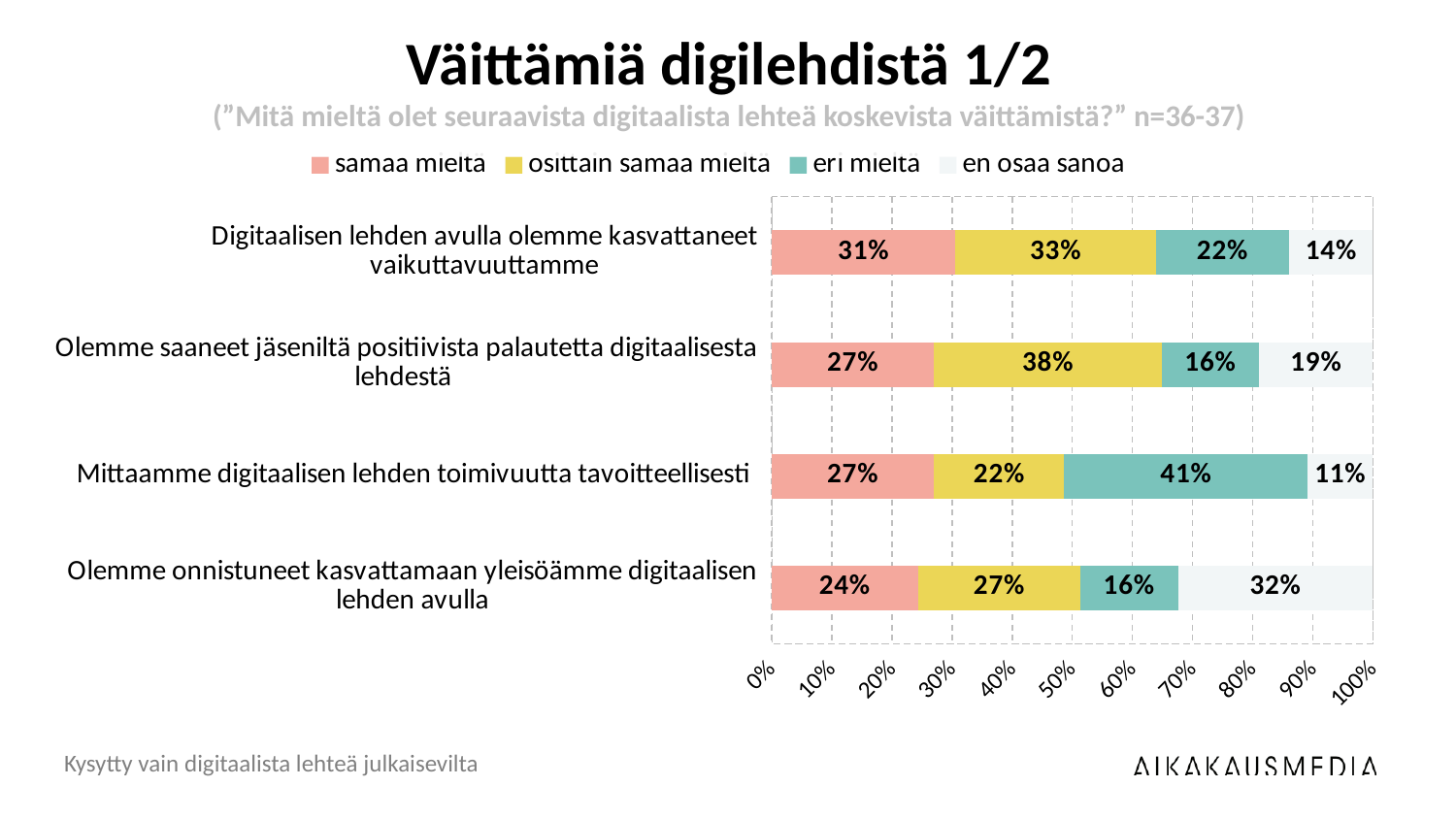
How many statements (categories) are plotted in the chart? 4 What kind of chart is shown on the slide? stacked bar chart How many series does the legend list? 4 What is the title of the chart on the slide? Väittämiä digilehdistä 1/2 What is the 'osittain samaa mieltä' value for 'Olemme saaneet jäseniltä positiivista palautetta digitaalisesta lehdestä'? 38% Which statement has the highest 'eri mieltä' share? Mittaamme digitaalisen lehden toimivuutta tavoitteellisesti What is the 'samaa mieltä' value for 'Digitaalisen lehden avulla olemme kasvattaneet vaikuttavuuttamme'? 31% What is the 'eri mieltä' value for 'Mittaamme digitaalisen lehden toimivuutta tavoitteellisesti'? 41% Which statement has the lowest 'en osaa sanoa' share? Mittaamme digitaalisen lehden toimivuutta tavoitteellisesti What is the 'en osaa sanoa' value for 'Olemme onnistuneet kasvattamaan yleisöämme digitaalisen lehden avulla'? 32% What is the difference between the 'osittain samaa mieltä' values for 'Olemme saaneet jäseniltä positiivista palautetta digitaalisesta lehdestä' and 'Mittaamme digitaalisen lehden toimivuutta tavoitteellisesti'? 16% Which is larger: the 'samaa mieltä' value for 'Digitaalisen lehden avulla olemme kasvattaneet vaikuttavuuttamme' or for 'Olemme onnistuneet kasvattamaan yleisöämme digitaalisen lehden avulla'? Digitaalisen lehden avulla olemme kasvattaneet vaikuttavuuttamme